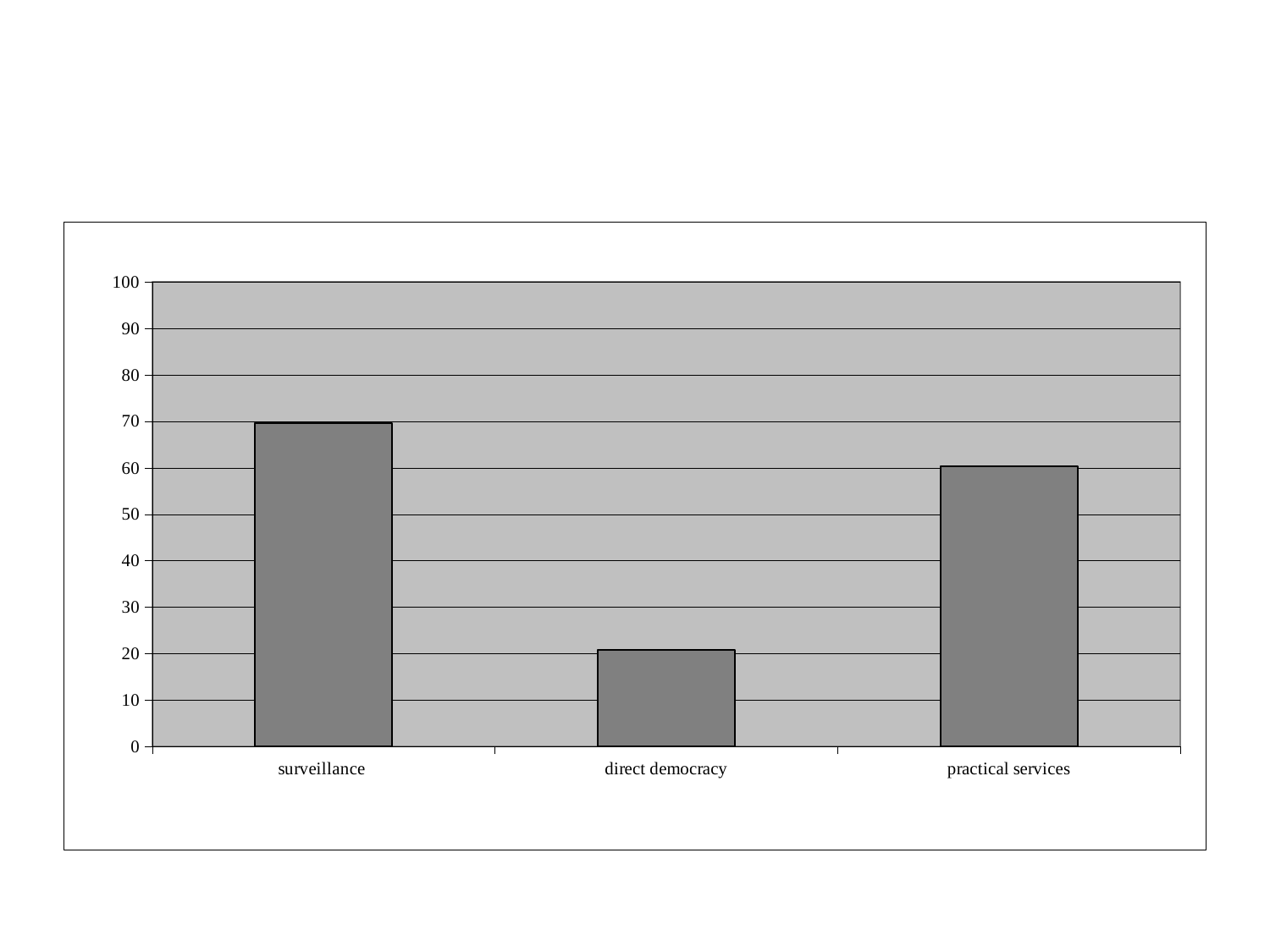
Is the value for surveillance greater or less than 60? greater What kind of chart is shown on the slide? bar chart Which is larger, the value for direct democracy or the value for practical services? practical services Which category has the lowest bar? direct democracy Is the value for surveillance greater or less than 80? less Is the value for practical services greater or less than 50? greater How many categories are shown on the x axis? 3 Which category has the highest bar? surveillance What is the highest value shown on the y axis? 100 Which is larger, the value for surveillance or the value for practical services? surveillance